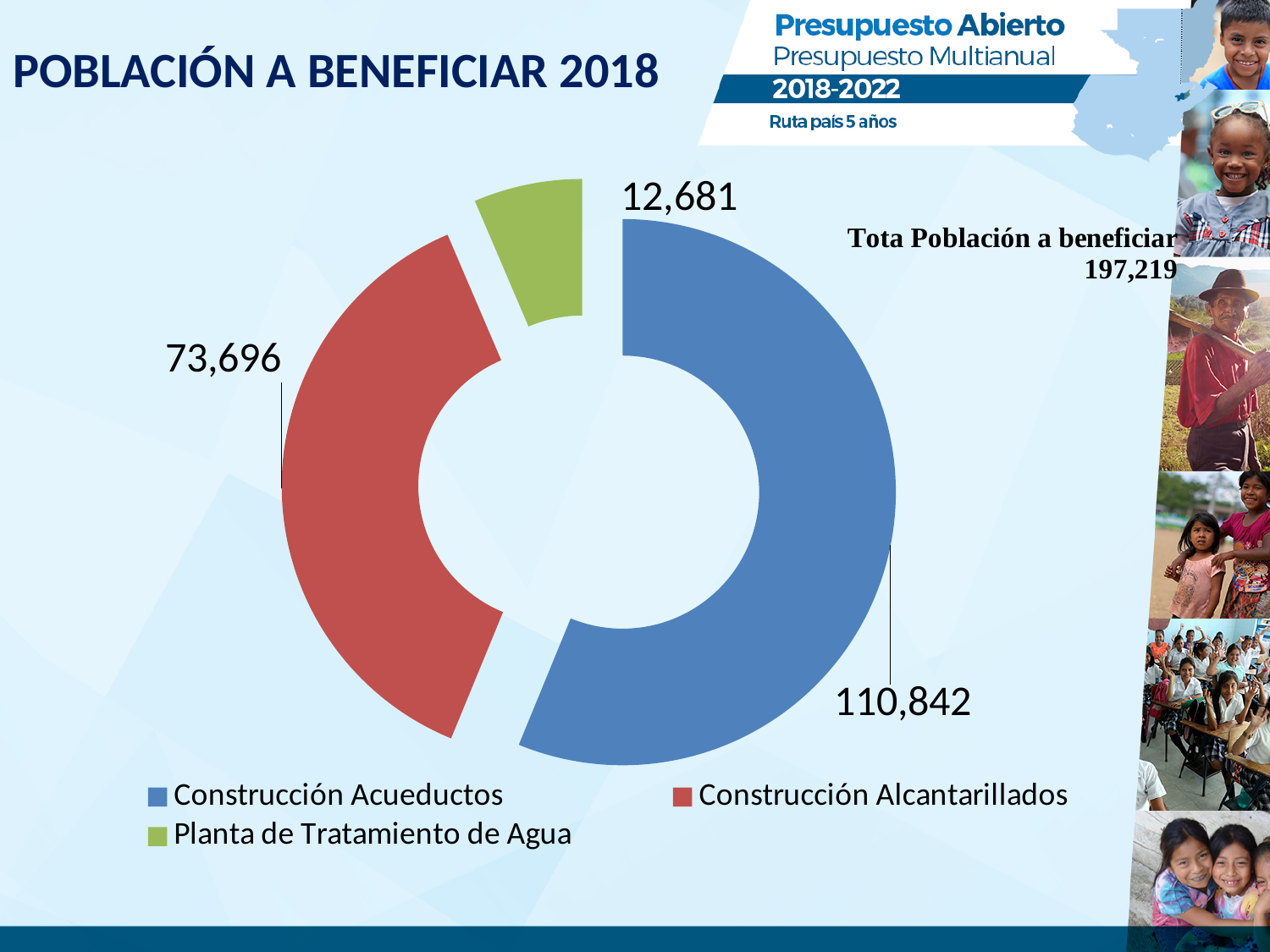
What is the value for Construcción Acueductos? 110,842 What is the value for Planta de Tratamiento de Agua? 12,681 How many categories does the chart show? 3 What is the value for Construcción Alcantarillados? 73,696 What is the difference between the values for Construcción Alcantarillados and Planta de Tratamiento de Agua? 61,015 Which colour represents Planta de Tratamiento de Agua in the chart? Green Which category has the highest value? Construcción Acueductos Which is larger, the value for Construcción Alcantarillados or the value for Planta de Tratamiento de Agua? Construcción Alcantarillados What is the total population to benefit shown on the slide? 197,219 What kind of chart is shown on the slide? Doughnut chart Which category has the lowest value? Planta de Tratamiento de Agua What is the difference between the values for Construcción Acueductos and Construcción Alcantarillados? 37,146